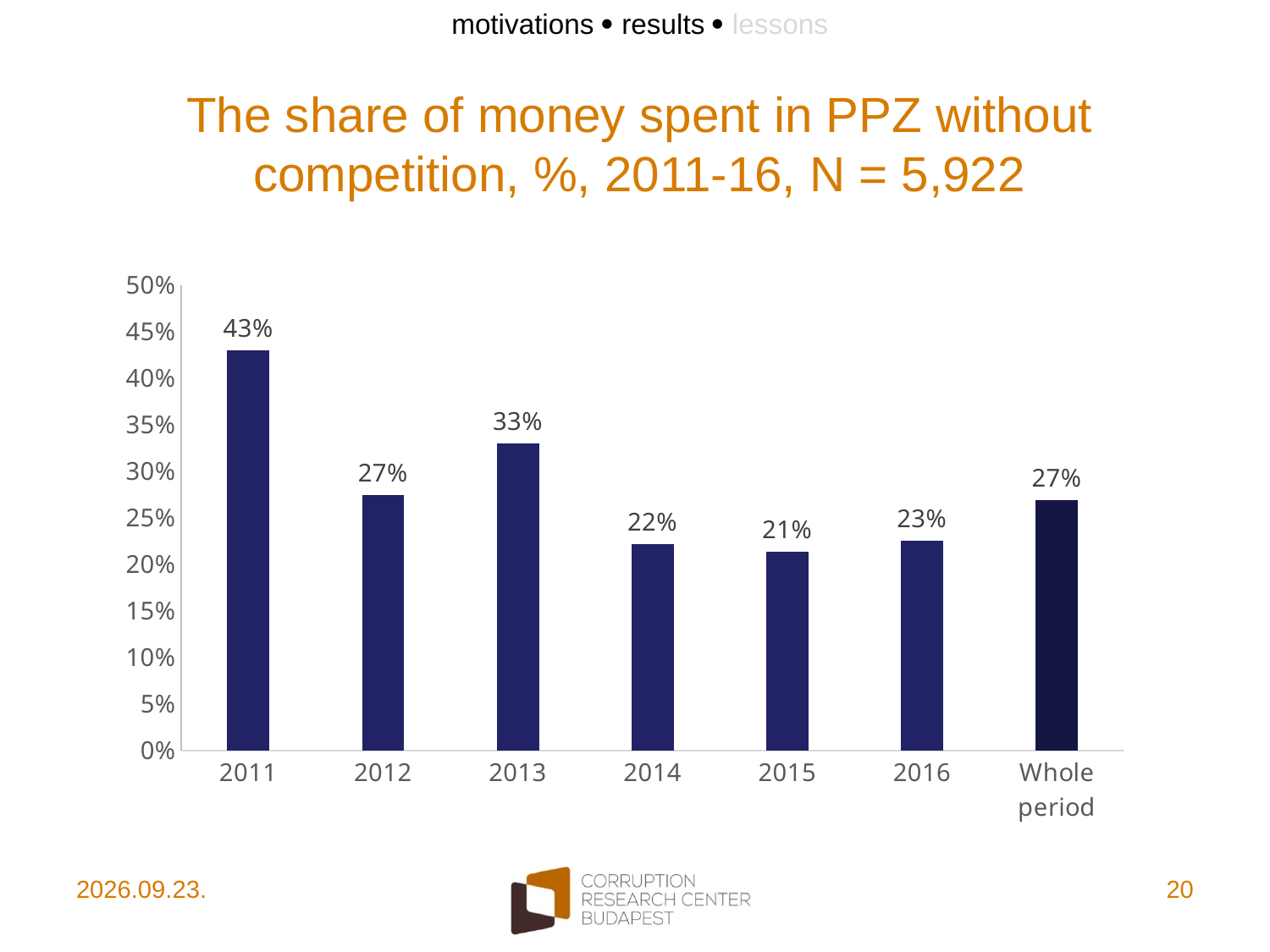
Which is larger, the value for 2012 or the value for 2014? 2012 Is the value for 2013 greater or less than 30%? greater What is the share of money spent without competition in 2011? 43% What is the difference between the values for 2011 and 2013? 10% What kind of chart is shown on the slide? bar chart What is the value shown for the whole period? 27% Which year has the highest share of money spent without competition? 2011 What is the difference between the values for 2013 and 2016? 10% Which year has the lowest share of money spent without competition? 2015 What is the value shown for 2014? 22% How many categories are shown on the x axis? 7 What is the title of the chart? The share of money spent in PPZ without competition, %, 2011-16, N = 5,922